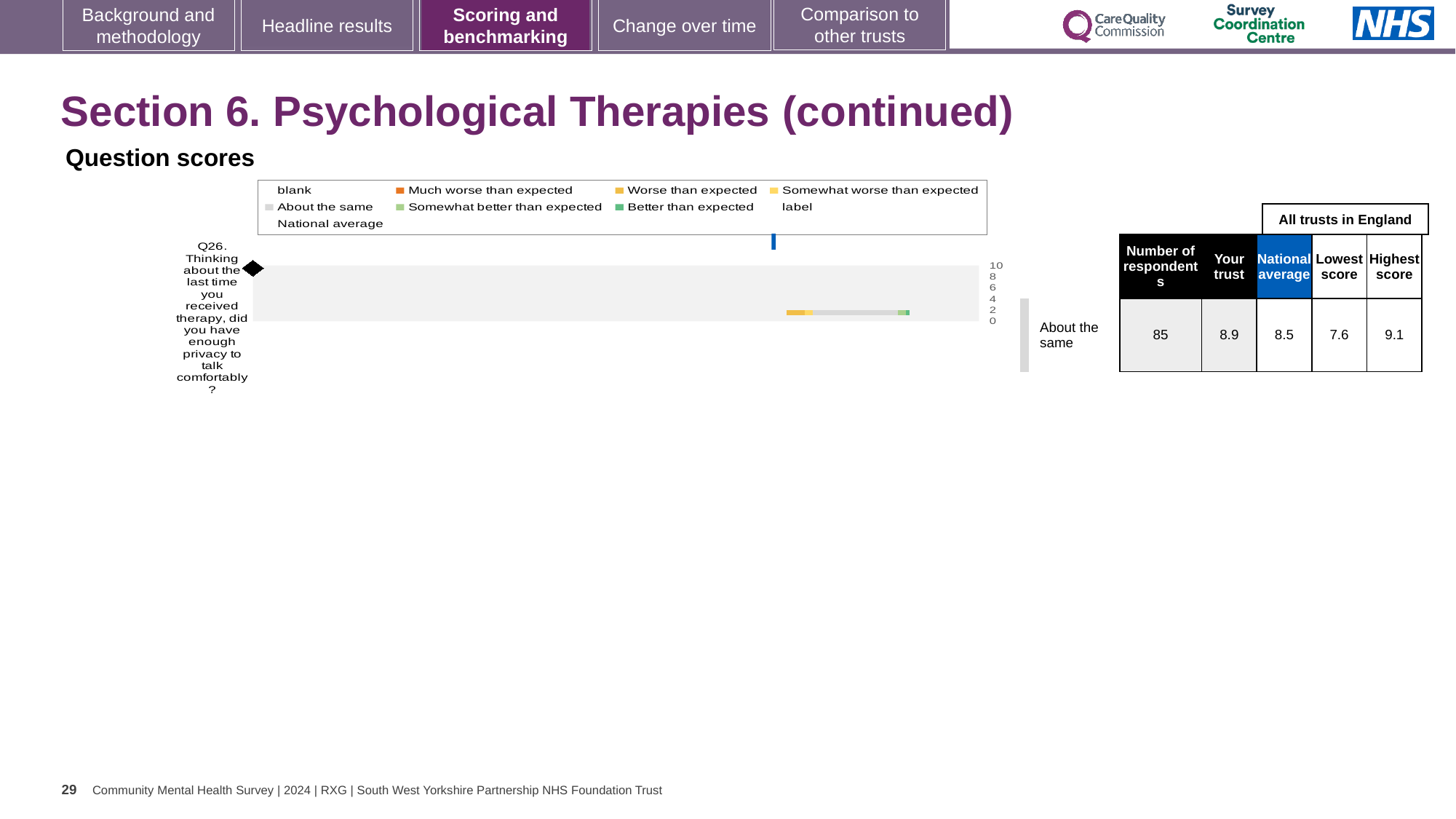
In the table beside the chart, what is the Highest score among all trusts in England for Q26? 9.1 How many respondents answered Q26 according to the table beside the chart? 85 What benchmark category is shown for Q26 next to the chart? About the same What is the difference between the 'Your trust' score and the National average for Q26? 0.4 In the table beside the chart, what is the 'Your trust' score for Q26? 8.9 What kind of chart is shown under 'Question scores'? bar chart How many questions are plotted in the Question scores chart? 1 What is the difference between the Highest score and the Lowest score for Q26 in the table? 1.5 In the table beside the chart, what is the Lowest score among all trusts in England for Q26? 7.6 Which question is plotted in the Question scores chart? Q26. Thinking about the last time you received therapy, did you have enough privacy to talk comfortably? Which is larger for Q26, the 'Your trust' score or the National average score? Your trust In the table beside the chart, what is the National average score for Q26? 8.5